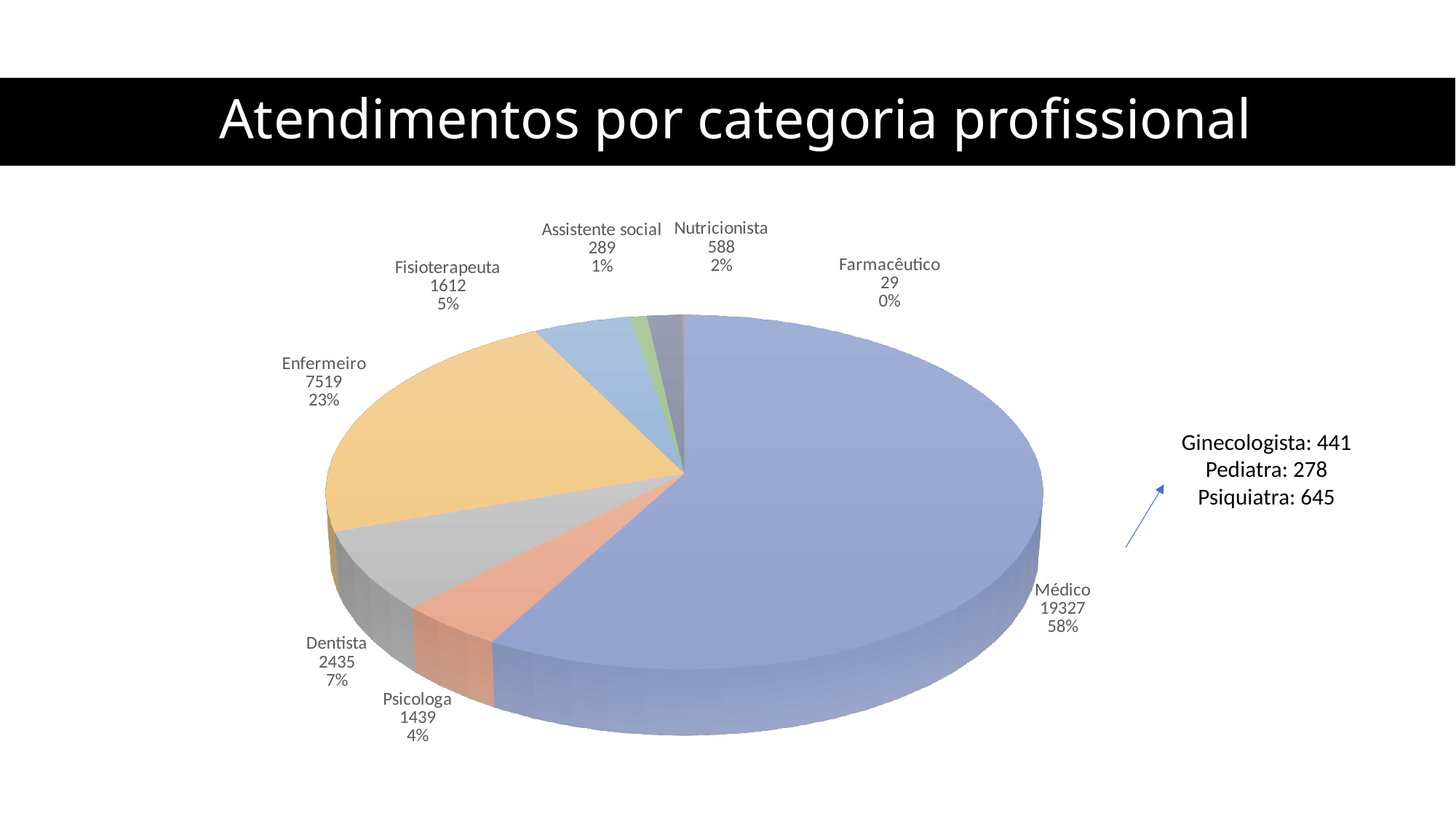
What type of chart is shown on the slide? Pie chart What is the title of the chart on the slide? Atendimentos por categoria profissional How many categories are labelled on the pie chart? 8 What percentage share does the Enfermeiro slice have? 23% Which labelled category has the smallest value? Farmacêutico Which is larger, the value for Fisioterapeuta or the value for Nutricionista? Fisioterapeuta What value is shown for Enfermeiro? 7519 How many atendimentos are shown for Médico? 19327 What is the difference between the values for Dentista and Psicologa? 996 What value is shown for Assistente social? 289 Which category has the largest slice of the pie? Médico What percentage share does the Dentista slice have? 7%